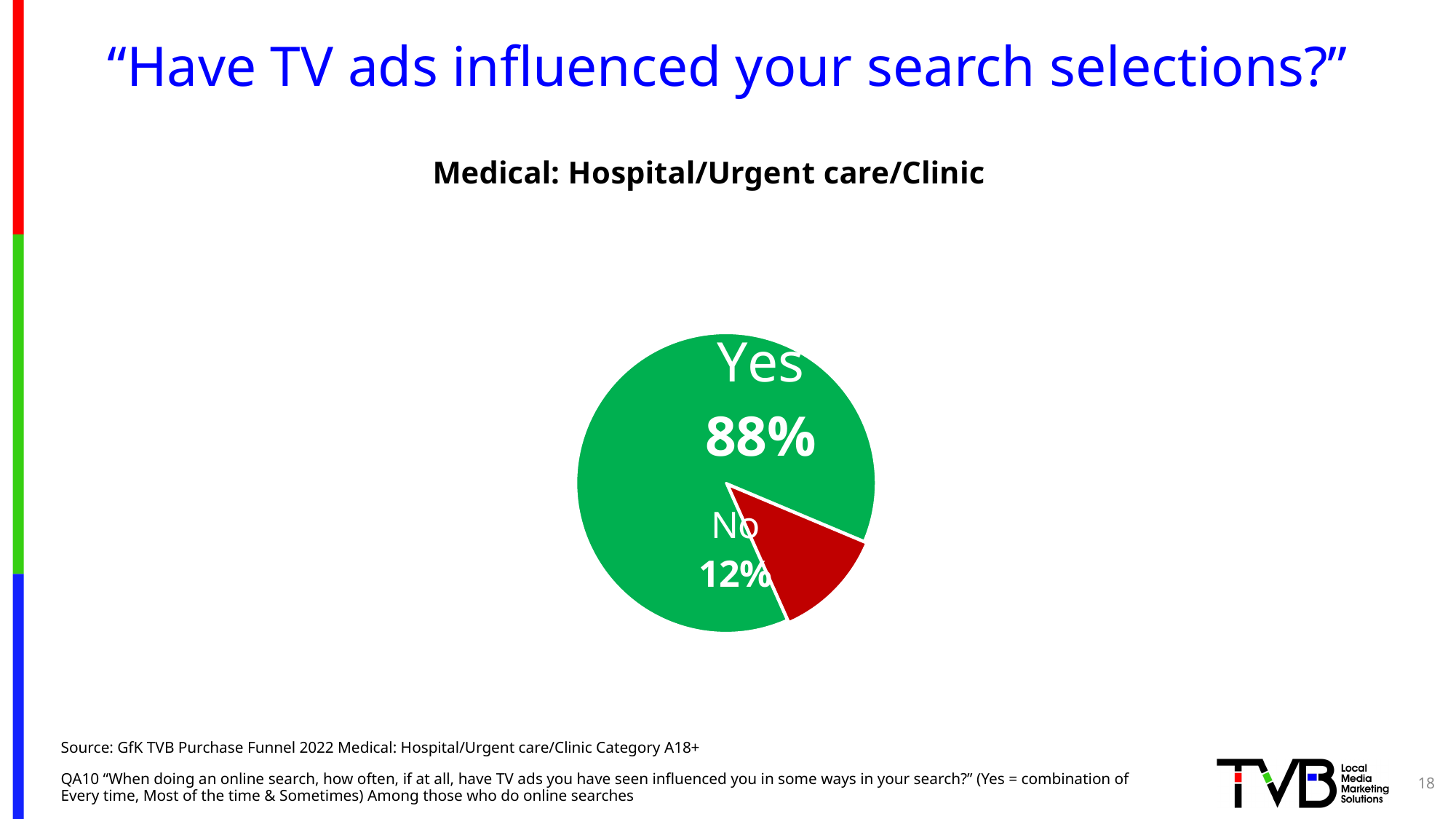
What share of the pie does the No slice represent? 12% What kind of chart is shown on the slide? Pie chart How many slices does the pie chart have? 2 What percentage of respondents answered No? 12% What is the difference in percentage points between the Yes and No slices? 76 Which slice of the pie is the smallest? No What category does the chart subtitle say the data is for? Medical: Hospital/Urgent care/Clinic What percentage of respondents answered Yes? 88% Which is larger, the Yes slice or the No slice? Yes What colour is the Yes slice? Green Which slice of the pie is the largest? Yes